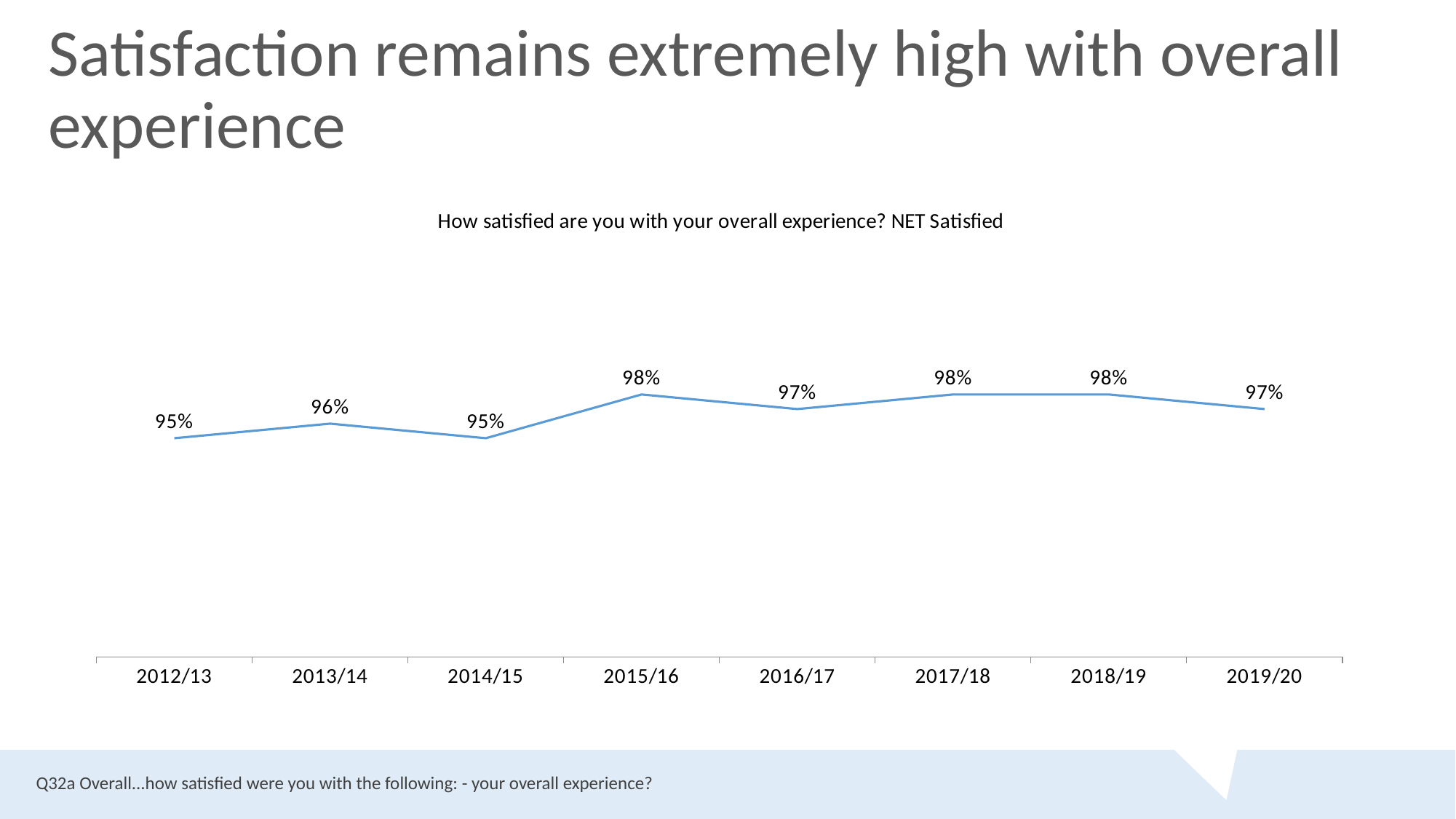
Does the NET Satisfied value rise or fall from 2012/13 to 2015/16? Rise What is the NET Satisfied value for 2015/16? 98% What is the NET Satisfied value for 2019/20? 97% What is the difference between the NET Satisfied values for 2018/19 and 2019/20? 1% What is the NET Satisfied value for 2012/13? 95% How many years are plotted on the chart? 8 Which year has the lowest NET Satisfied value, 2013/14 or 2014/15? 2014/15 Is the NET Satisfied value for 2016/17 larger than the value for 2014/15? Yes What is the difference between the NET Satisfied values for 2015/16 and 2012/13? 3% What is the title of the chart? How satisfied are you with your overall experience? NET Satisfied What is the NET Satisfied value for 2013/14? 96% What kind of chart is shown on the slide? Line chart